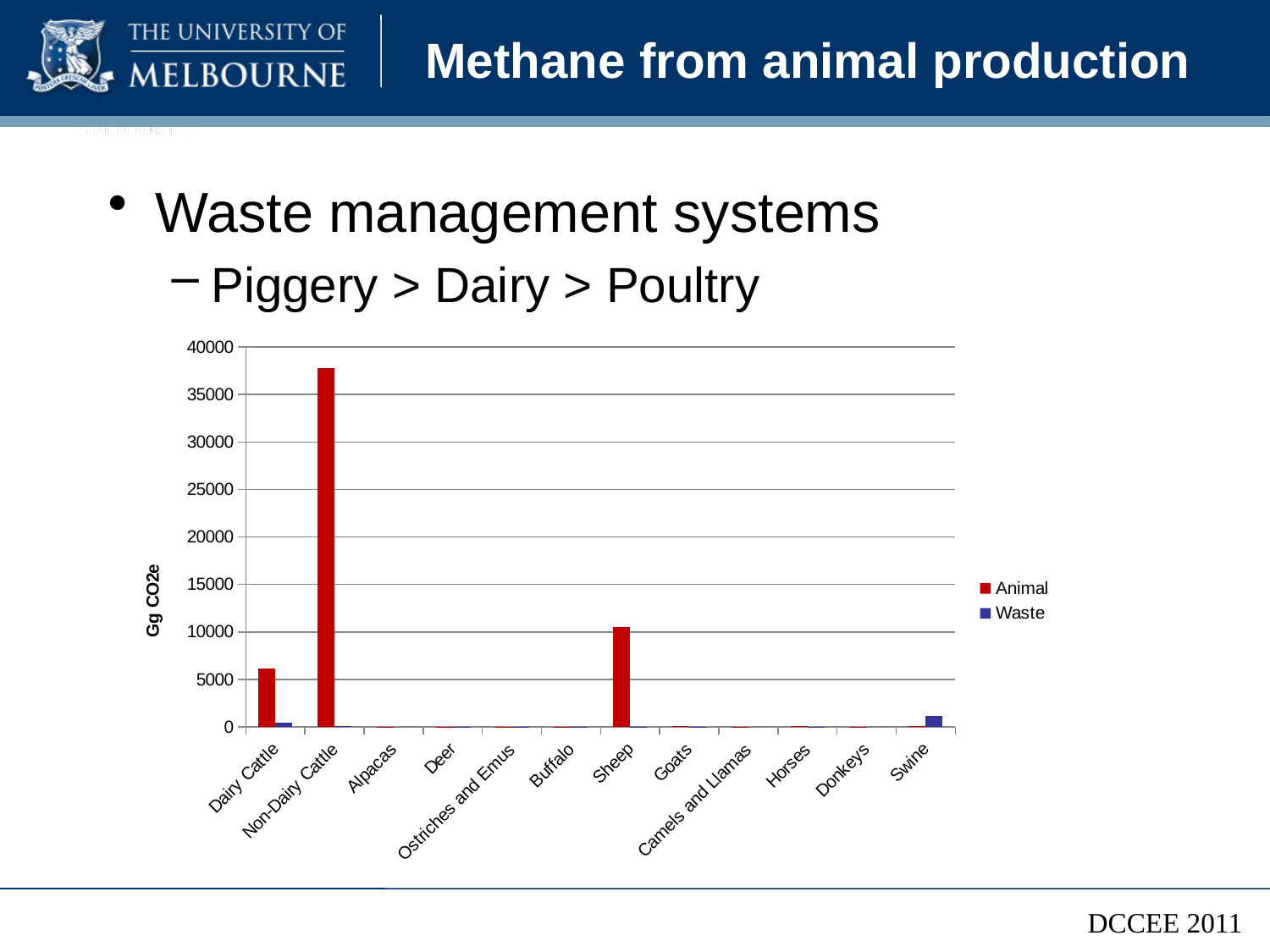
Is the Animal value for Non-Dairy Cattle greater or less than 35000? greater Which category has the highest Animal value in the chart? Non-Dairy Cattle Which has the larger Animal value, Sheep or Dairy Cattle? Sheep What is the label on the y axis of the chart? Gg CO2e What type of chart is shown on the slide? bar chart How many animal categories are shown on the x axis of the chart? 12 Is the Animal value for Dairy Cattle greater or less than 10000? less Which category has the highest Waste value in the chart? Swine How many series does the chart legend list? 2 Which has the larger Waste value, Swine or Dairy Cattle? Swine Is the Animal value for Dairy Cattle greater or less than 5000? greater